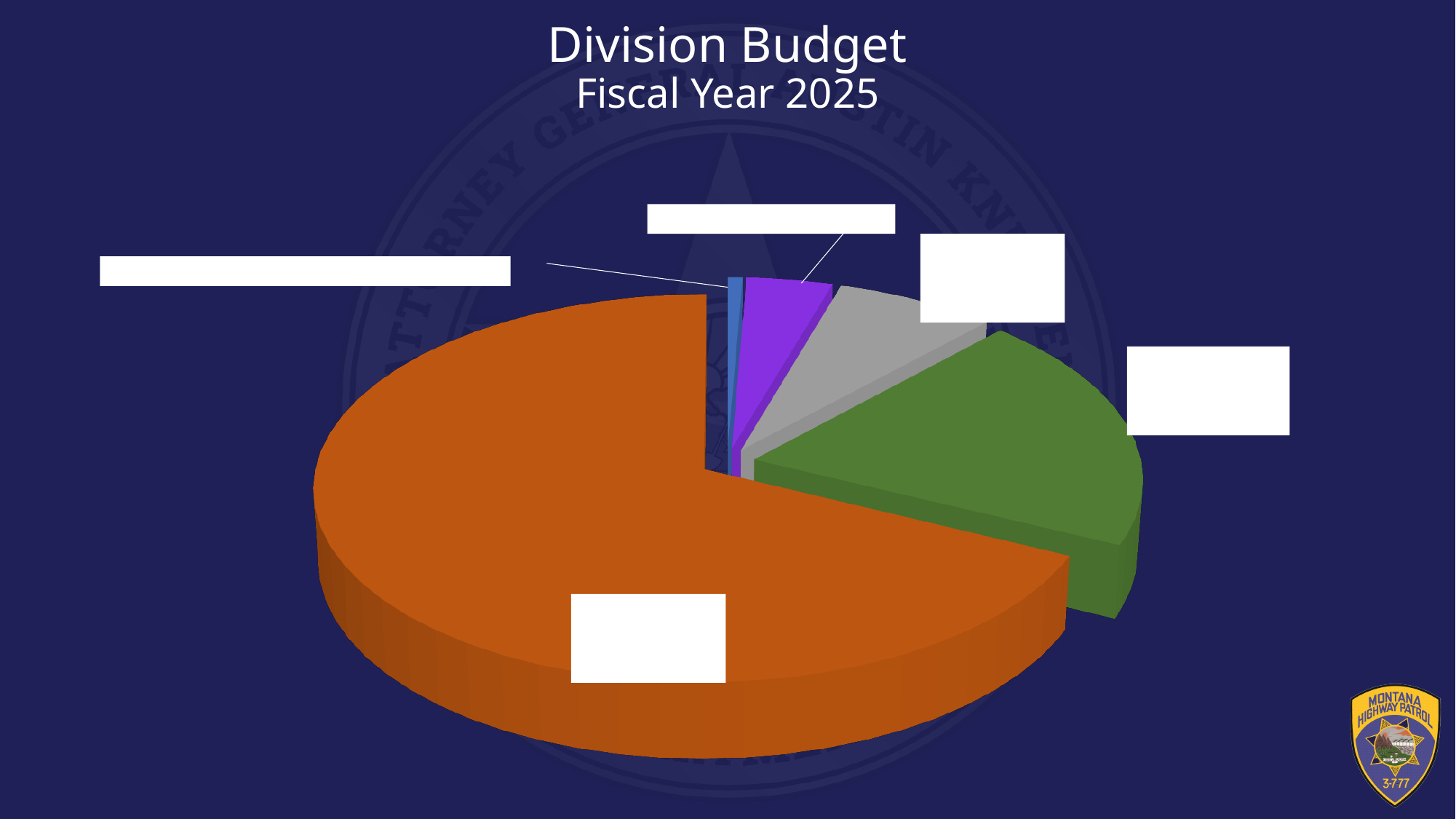
What kind of chart is shown on the slide? Pie chart Which slice of the Division Budget pie chart is the largest? The orange slice In the Division Budget pie chart, which is larger, the green slice or the gray slice? The green slice Which fiscal year does the Division Budget chart cover? Fiscal Year 2025 Does the orange slice of the Division Budget pie chart account for more or less than half of the pie? More What is the title of the chart on the slide? Division Budget Fiscal Year 2025 Which slice of the Division Budget pie chart is the smallest? The blue slice In the Division Budget pie chart, which is larger, the orange slice or the green slice? The orange slice How many slices does the Division Budget pie chart have? 5 In the Division Budget pie chart, which is larger, the purple slice or the blue slice? The purple slice